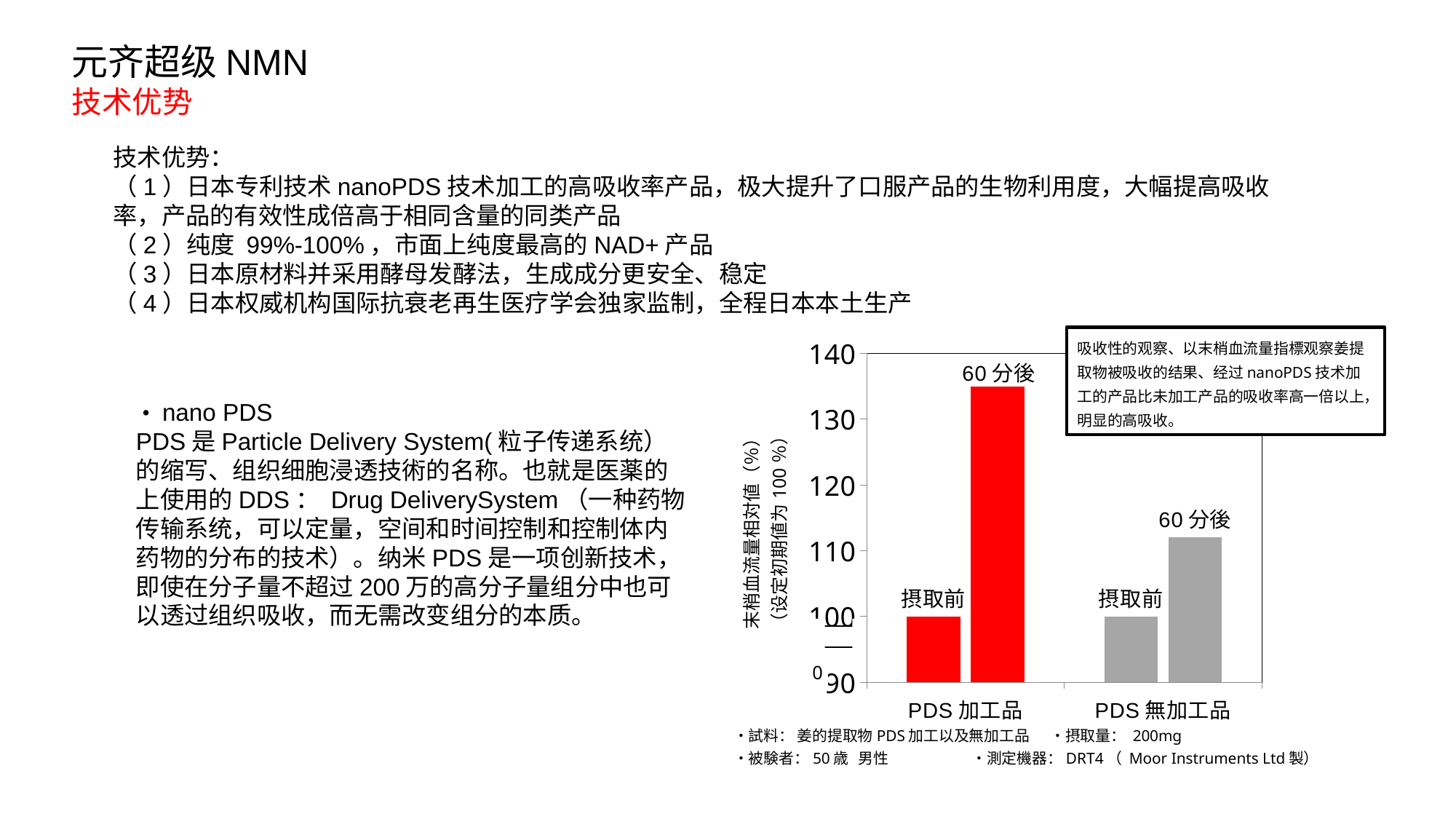
What value does the 摂取前 bar for PDS加工品 reach on the y axis? 100 What colour are the bars for PDS加工品? red Is the 60分後 value for PDS加工品 greater or less than 130? greater How many category groups are shown on the x axis of the chart? 2 What kind of chart is shown on the slide? bar chart Which bar is the highest in the chart? PDS加工品 60分後 Is the 60分後 value for PDS無加工品 greater or less than 110? greater Which is larger: the 60分後 value for PDS加工品 or the 60分後 value for PDS無加工品? PDS加工品 For PDS加工品, does the value rise or fall from 摂取前 to 60分後? rise Is the 60分後 value for PDS無加工品 greater or less than 120? less How many bars are plotted in the chart? 4